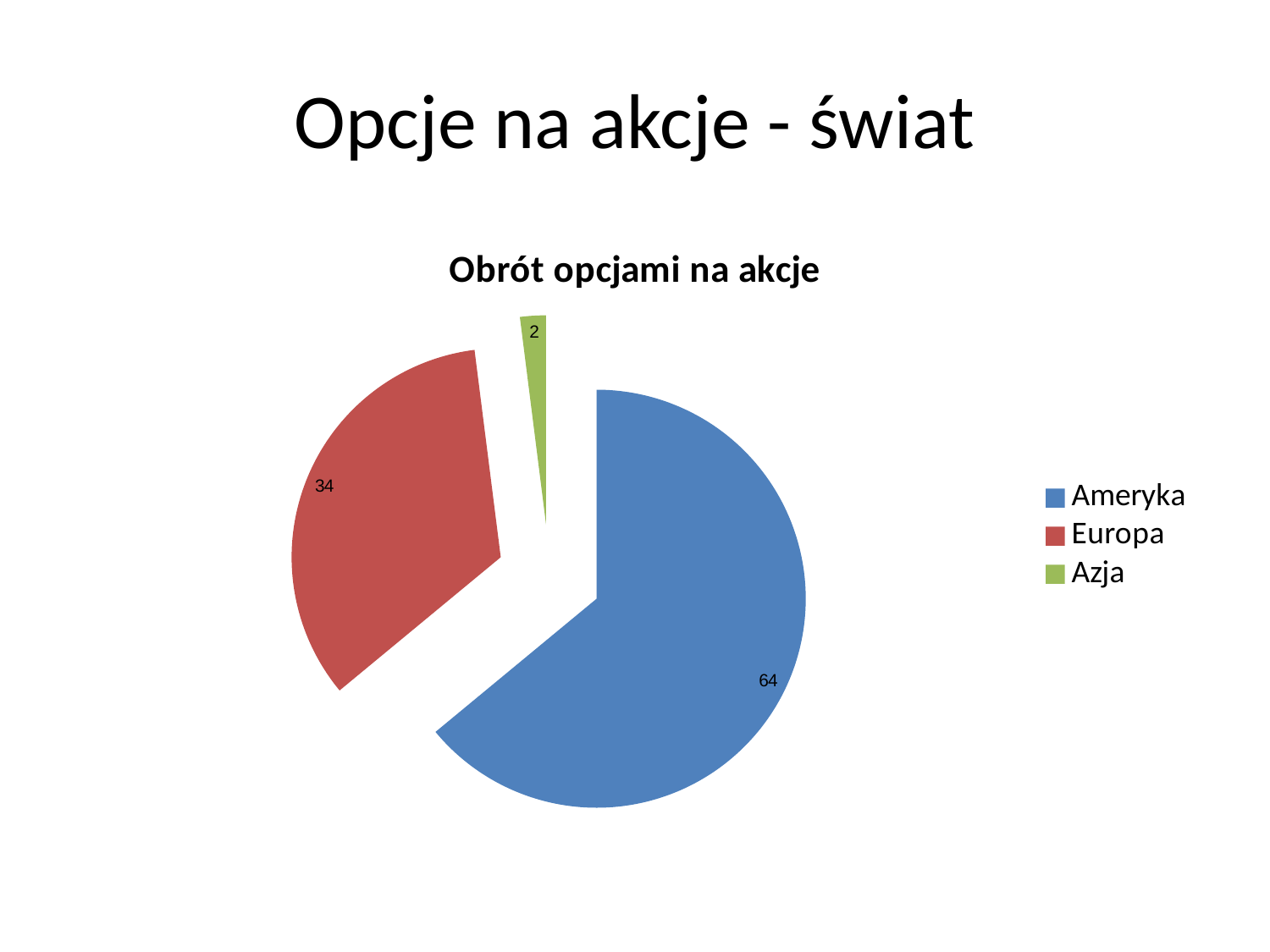
Which category has the largest slice? Ameryka How many slices does the pie chart have? 3 Which is larger, the value for Europa or the value for Azja? Europa What is the title of the chart? Obrót opcjami na akcje Which category has the smallest slice? Azja What is the value for Ameryka? 64 What colour is the slice for Europa? red What type of chart is shown on the slide? pie chart What is the difference between the values for Ameryka and Europa? 30 What is the value for Europa? 34 What is the difference between the values for Europa and Azja? 32 What is the value for Azja? 2